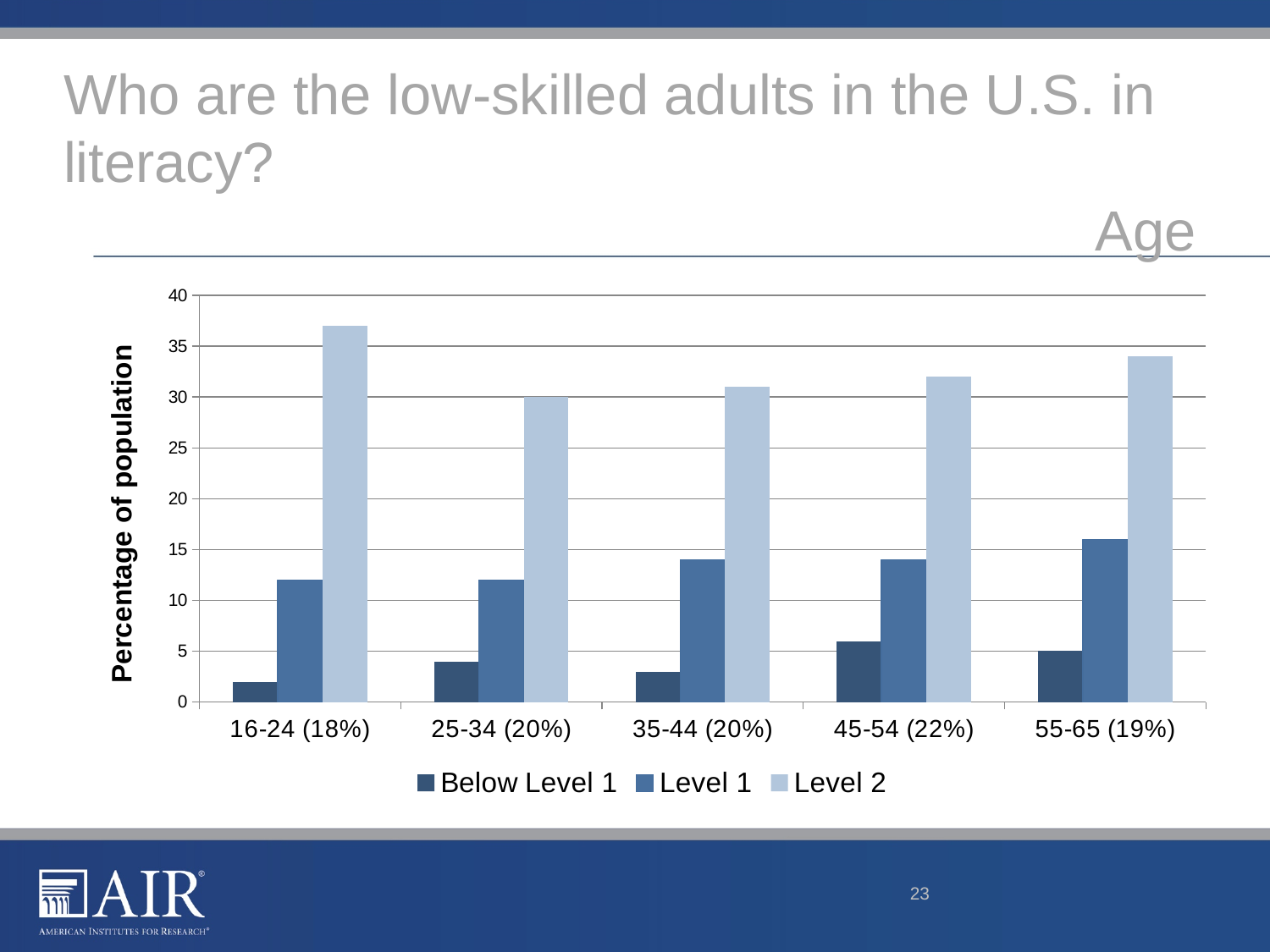
Is the Level 1 value for 55-65 (19%) greater or less than 15? greater What kind of chart is shown on the slide? bar chart Is the Below Level 1 value for 25-34 (20%) greater or less than 5? less How many series does the legend list? 3 Is the Level 2 value for 45-54 (22%) greater or less than 30? greater Which is larger, the Level 2 value for 16-24 (18%) or the Level 2 value for 25-34 (20%)? 16-24 (18%) Which is larger, the Level 1 value for 55-65 (19%) or the Level 1 value for 16-24 (18%)? 55-65 (19%) What is the title of the y axis? Percentage of population How many age groups are shown on the x axis? 5 Which age group has the highest Level 2 value? 16-24 (18%) Do the Level 1 values generally rise or fall from the youngest to the oldest age group? rise